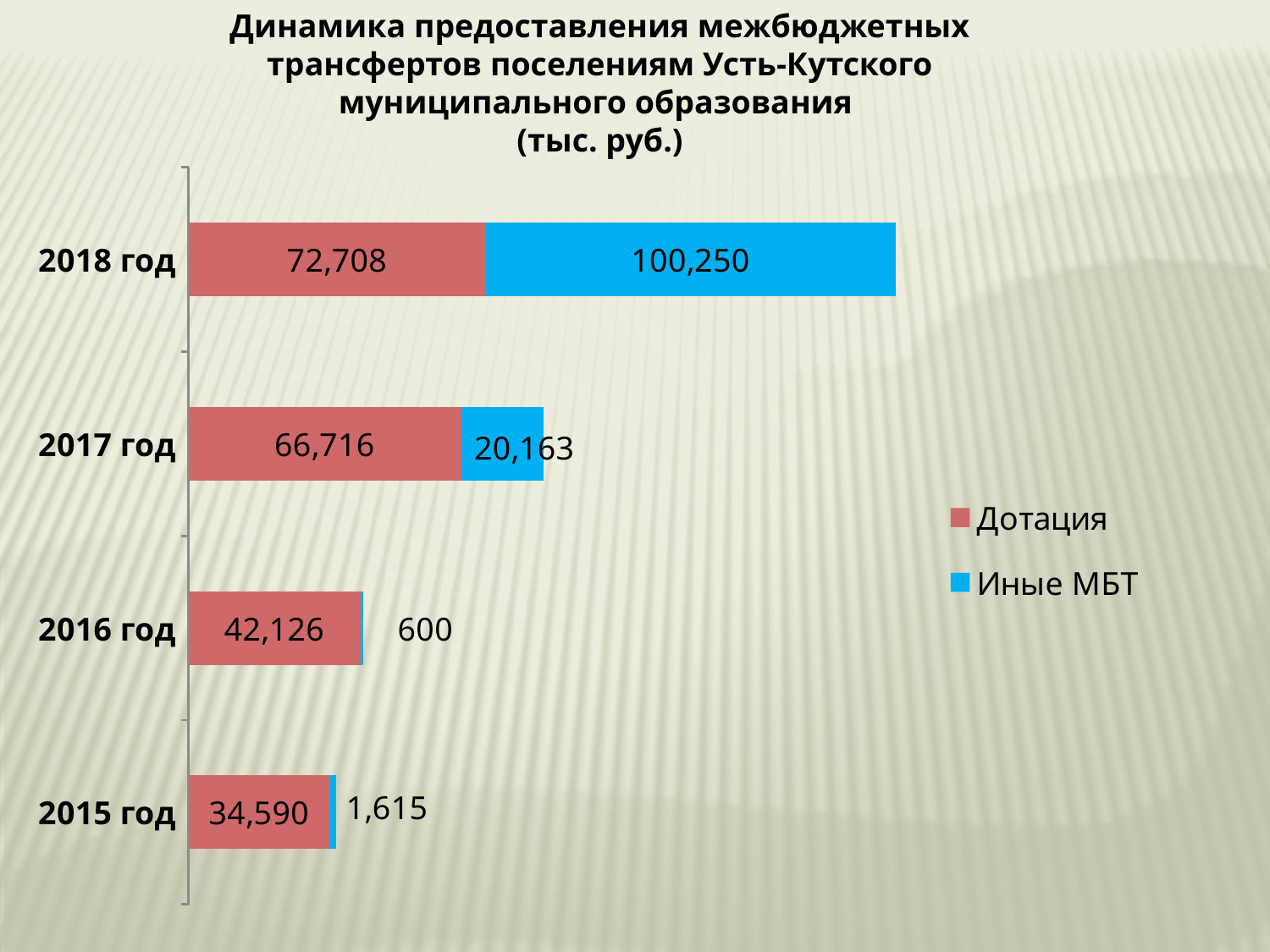
Which is larger: Дотация for 2016 год or Дотация for 2015 год? Дотация for 2016 год What is the difference between the Дотация values for 2018 год and 2017 год? 5,992 What is the value of Иные МБТ for 2016 год? 600 What is the value of Дотация for 2018 год? 72,708 What is the value of Иные МБТ for 2017 год? 20,163 How many series does the legend list? 2 Which year has the lowest value of Дотация? 2015 год What is the total of the stacked bar for 2018 год? 172,958 What kind of chart is shown on the slide? Stacked bar chart Which year has the highest value of Иные МБТ? 2018 год What is the total of the stacked bar for 2017 год? 86,879 What is the value of Дотация for 2015 год? 34,590